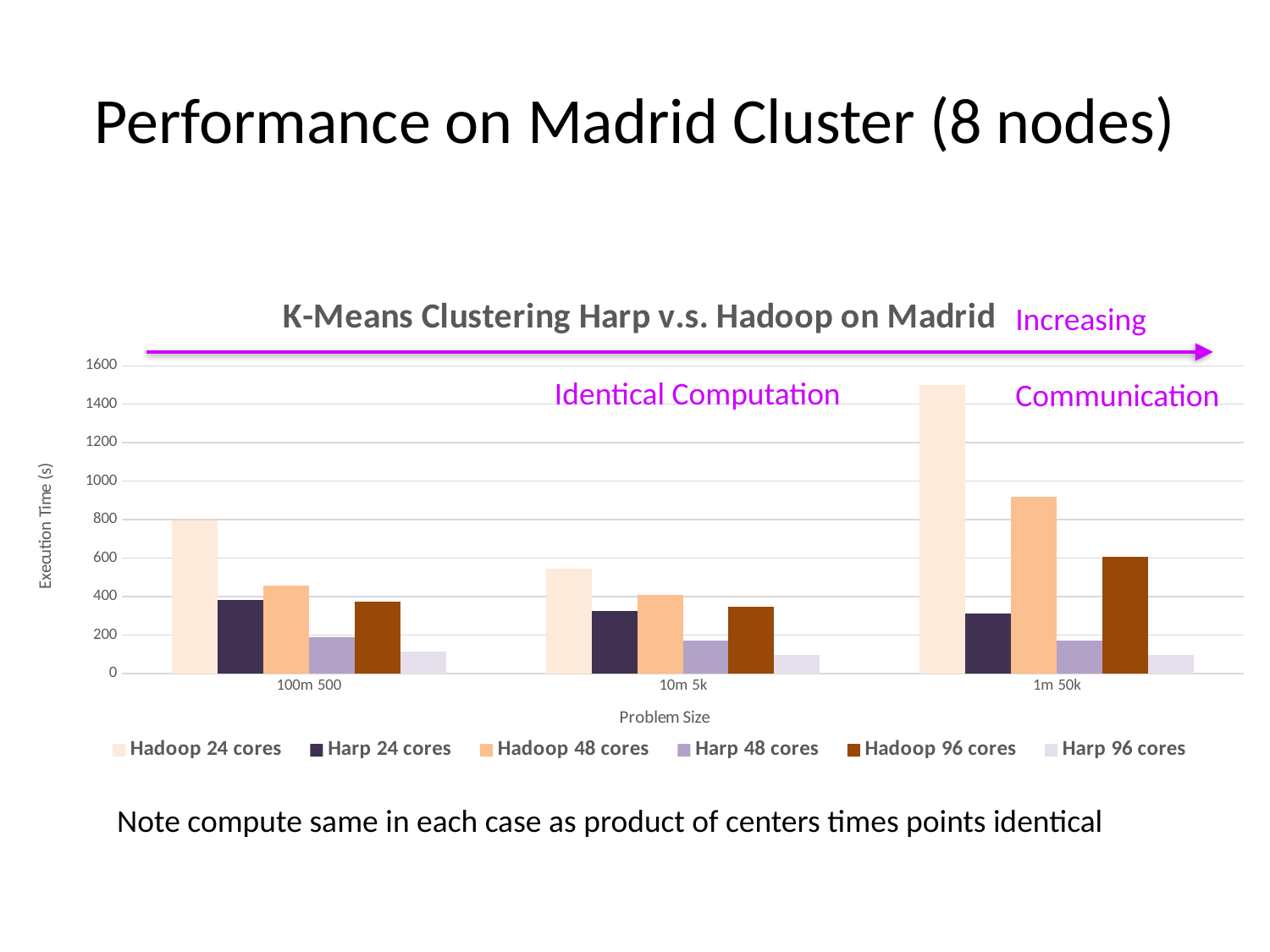
How many problem sizes are shown on the x axis? 3 What kind of chart is shown on the slide? bar chart At 1m 50k, which is larger: Hadoop 96 cores or Harp 24 cores? Hadoop 96 cores What is the label of the y axis? Execution Time (s) For which problem size is the Hadoop 24 cores bar the highest? 1m 50k How many series does the legend list? 6 Which series has the lowest bar at 1m 50k? Harp 96 cores At 1m 50k, which is larger: Hadoop 48 cores or Harp 48 cores? Hadoop 48 cores Is the value for Hadoop 48 cores at 1m 50k greater or less than 800? greater Is the value for Harp 96 cores at 10m 5k greater or less than 200? less Is the value for Hadoop 24 cores at 100m 500 greater or less than 600? greater